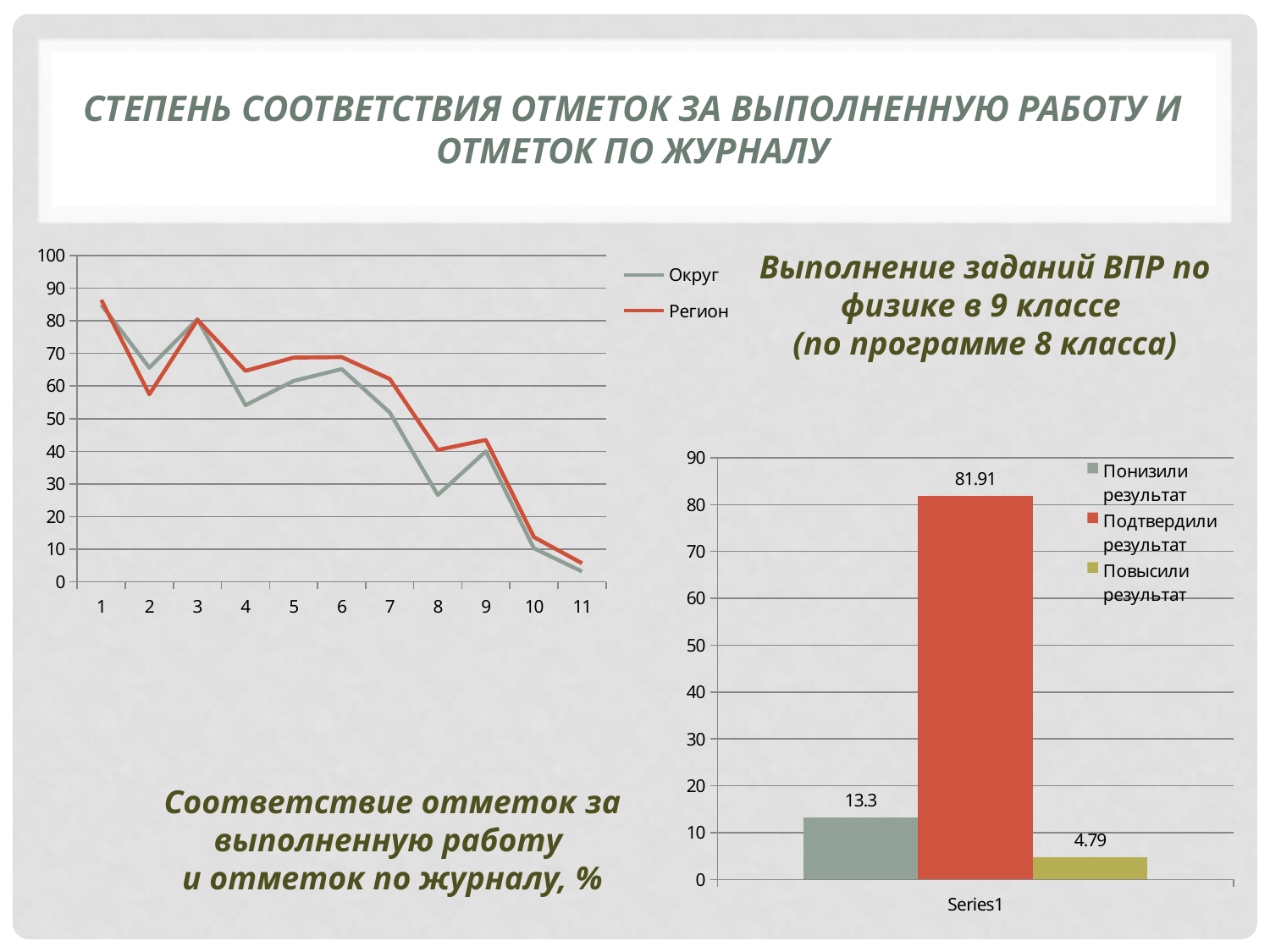
In the bar chart on the right, what is the value for Подтвердили результат? 81.91 In the line chart on the left, is the value for Регион at point 8 greater or less than 30? greater In the line chart on the left, how many series does the legend list? 2 In the bar chart on the right, what is the value for Понизили результат? 13.3 In the bar chart on the right, how many series does the legend list? 3 In the line chart on the left, how many points are on the x axis? 11 In the bar chart on the right, which series has the highest value? Подтвердили результат In the bar chart on the right, what is the difference between Подтвердили результат and Понизили результат? 68.61 In the bar chart on the right, which series has the lowest value? Повысили результат What kind of chart is the chart on the right? bar chart In the bar chart on the right, what is the value for Повысили результат? 4.79 In the line chart on the left, do the values generally rise or fall from point 1 to point 11? fall